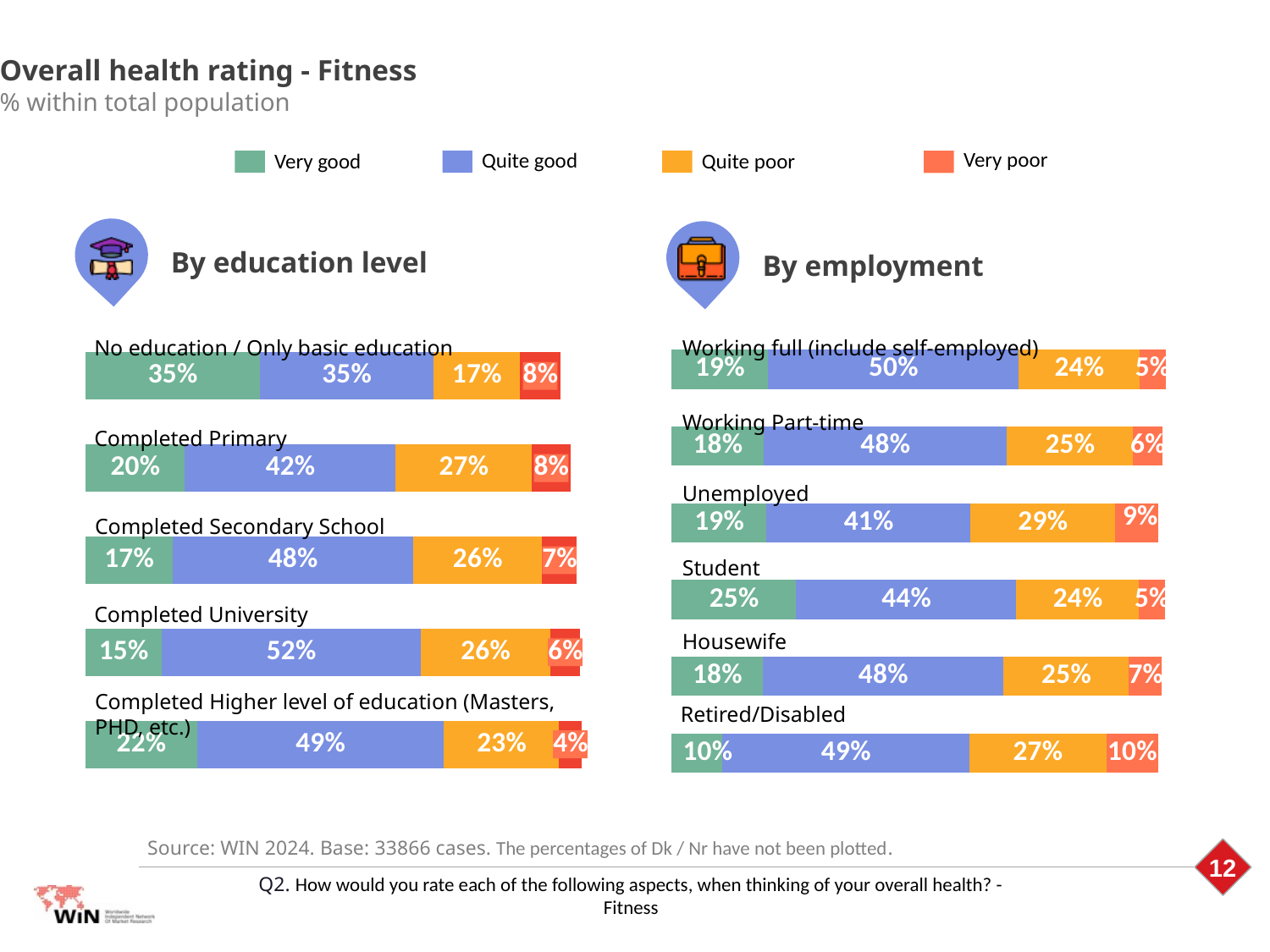
In the 'By education level' chart, which education level has the highest 'Very good' value? No education / Only basic education How many series does the legend list? 4 In the 'By employment' chart, which employment group has the highest 'Very good' value? Student In the 'By employment' chart, which employment group has the lowest 'Very good' value? Retired/Disabled What kind of chart is the 'By education level' chart? Stacked bar chart In the 'By education level' chart, what is the 'Very good' value for No education / Only basic education? 35% How many employment groups are shown in the 'By employment' chart? 6 In the 'By employment' chart, which is larger: the 'Quite good' value for Working full (include self-employed) or for Unemployed? Working full (include self-employed) In the 'By education level' chart, what is the 'Quite good' value for Completed University? 52% In the 'By education level' chart, what is the difference between the 'Quite poor' values for Completed Primary and Completed Higher level of education (Masters, PHD, etc.)? 4% In the 'By employment' chart, what is the 'Quite poor' value for Unemployed? 29% In the 'By education level' chart, which education level has the lowest 'Very poor' value? Completed Higher level of education (Masters, PHD, etc.)